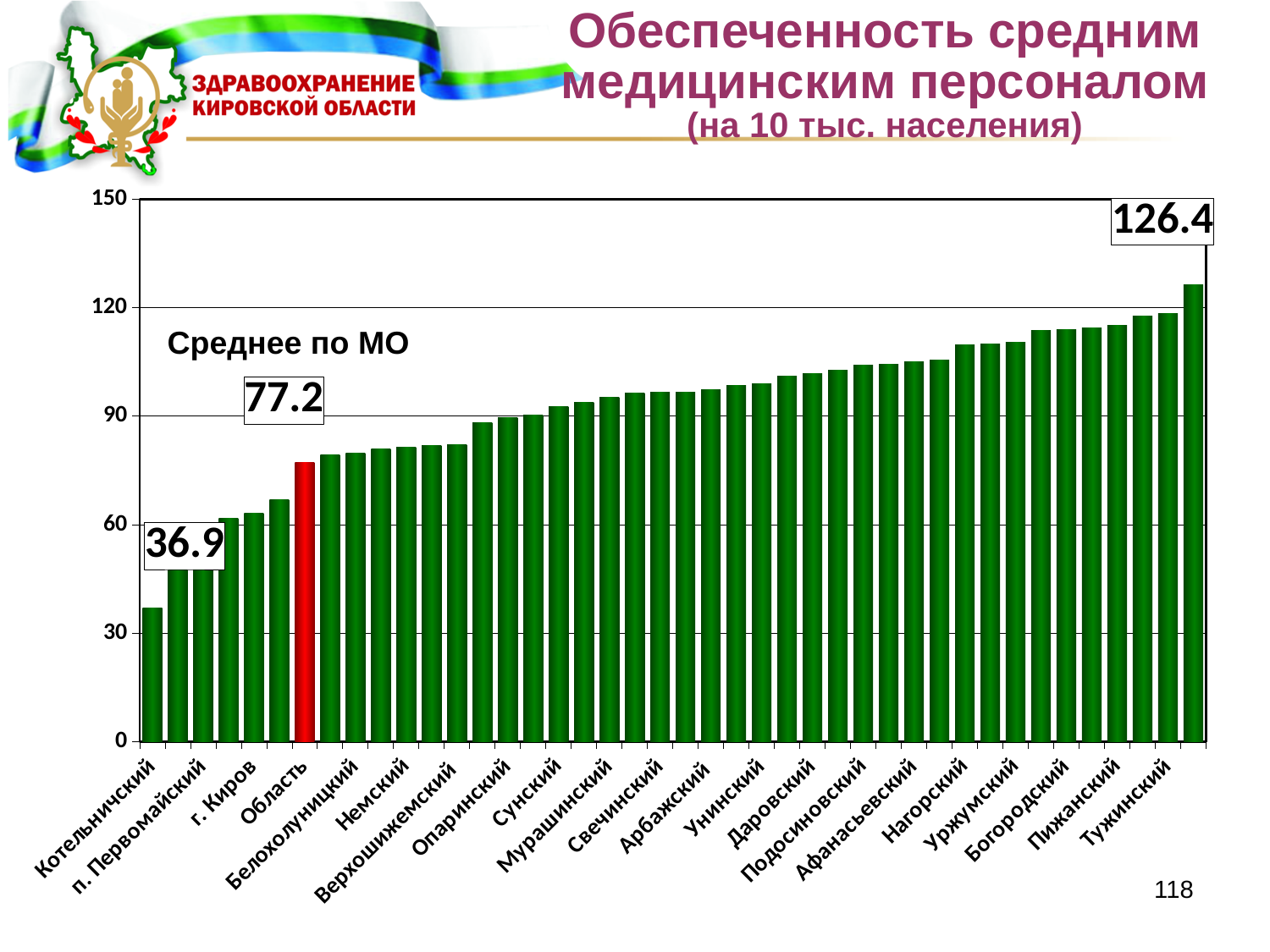
What is the difference between the highest value (126.4) and the lowest value (36.9)? 89.5 How much higher is the Область value than the Котельничский value? 40.3 Which category has the lowest value? Котельничский Which is larger, the value for Область or the value for Котельничский? Область What is the highest value shown on the chart? 126.4 What is the value for Область (the red bar)? 77.2 What kind of chart is shown on the slide? bar chart Is the value for Богородский greater or less than 120? less Do the values rise or fall from left to right along the x axis? rise What is the value for Котельничский? 36.9 Is the value for Нагорский greater or less than 90? greater Is the value for Немский greater or less than 60? greater